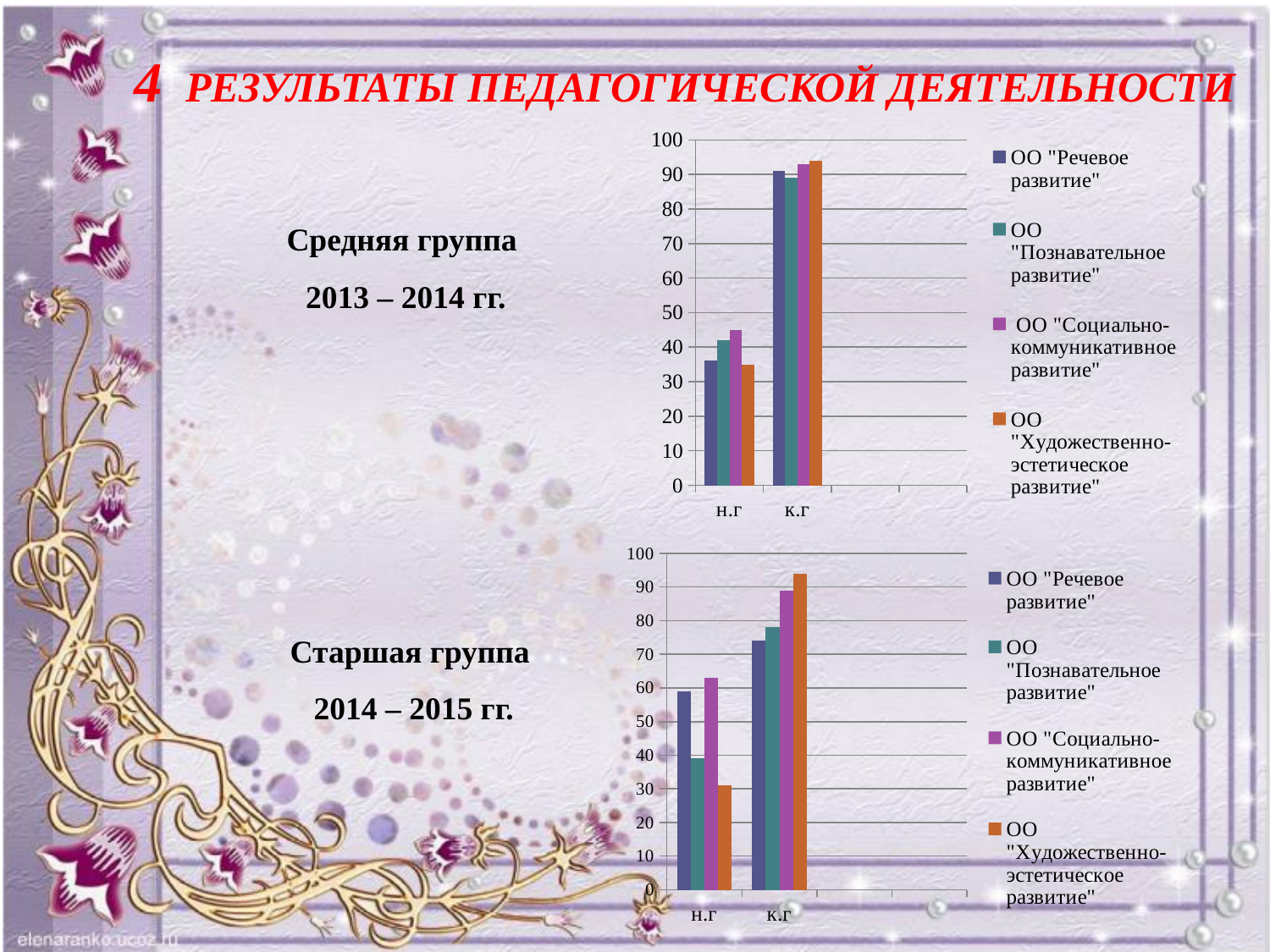
On the bottom chart (Старшая группа 2014 – 2015 гг.), is the value for ОО "Познавательное развитие" at н.г greater or less than 50? less On the top chart (Средняя группа 2013 – 2014 гг.), do the values rise or fall from н.г to к.г? rise On the bottom chart (Старшая группа 2014 – 2015 гг.), which series has the lowest value at н.г? ОО "Художественно-эстетическое развитие" On the bottom chart (Старшая группа 2014 – 2015 гг.), which is larger at н.г: ОО "Речевое развитие" or ОО "Познавательное развитие"? ОО "Речевое развитие" On the top chart (Средняя группа 2013 – 2014 гг.), is the value for ОО "Речевое развитие" at н.г greater or less than 50? less On the top chart (Средняя группа 2013 – 2014 гг.), is the value for ОО "Художественно-эстетическое развитие" at к.г greater or less than 90? greater On the top chart (Средняя группа 2013 – 2014 гг.), how many categories are shown on the x axis? 2 On the top chart (Средняя группа 2013 – 2014 гг.), what kind of chart is shown? bar chart On the top chart (Средняя группа 2013 – 2014 гг.), how many series does the legend list? 4 On the bottom chart (Старшая группа 2014 – 2015 гг.), what colour represents ОО "Художественно-эстетическое развитие" in the legend? orange On the bottom chart (Старшая группа 2014 – 2015 гг.), which series has the highest value at к.г? ОО "Художественно-эстетическое развитие"